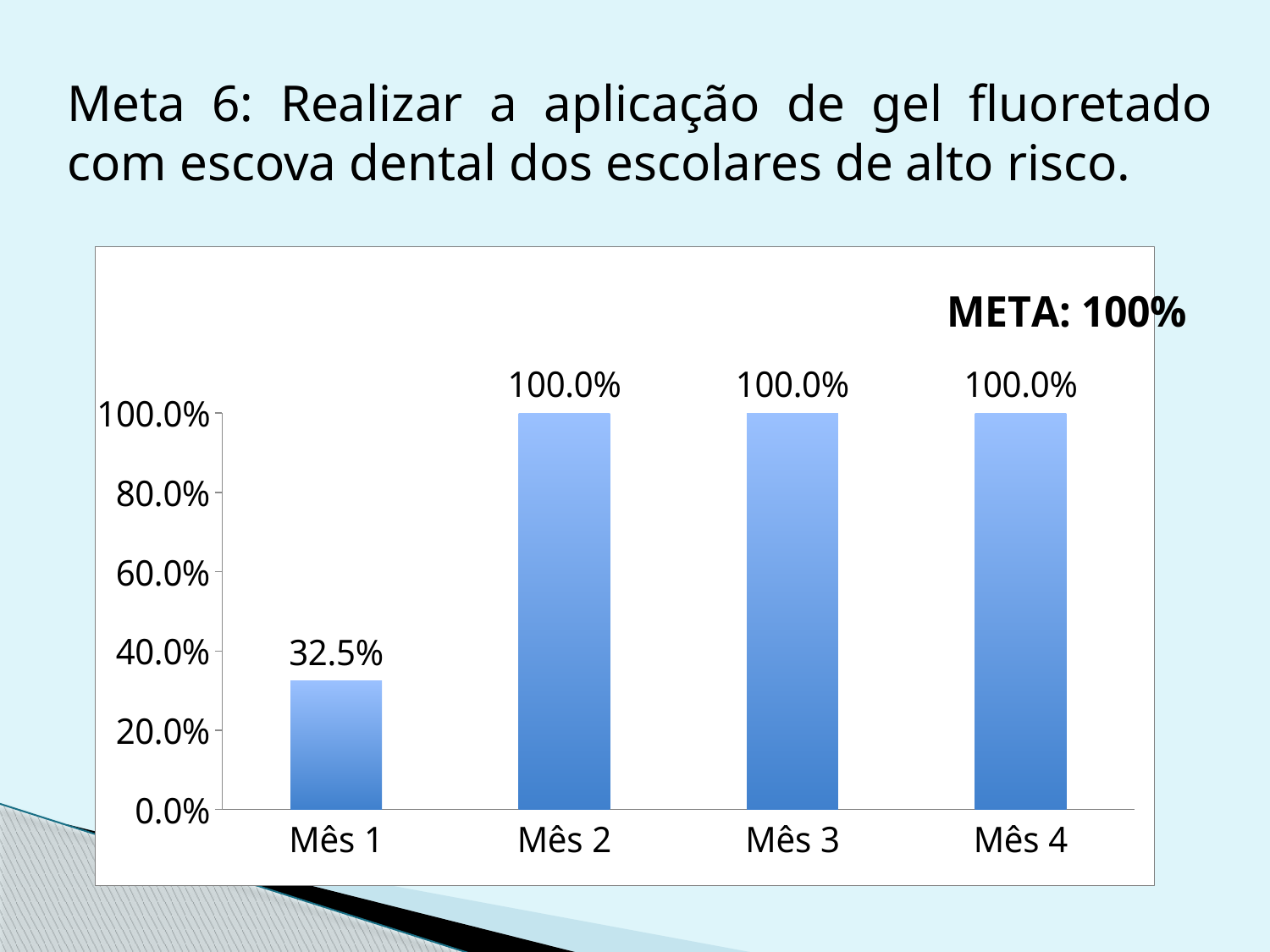
How many months are shown on the x axis? 4 How many months reached 100.0%? 3 Which month has the lowest value? Mês 1 Do the values rise or fall from Mês 1 to Mês 2? rise Is the value for Mês 1 greater or less than 40.0%? less Which is larger, the value for Mês 1 or the value for Mês 3? Mês 3 What is the value for Mês 1? 32.5% What target (META) is stated on the chart? 100% What kind of chart is shown on the slide? bar chart What is the difference between the values for Mês 2 and Mês 1? 67.5% What is the value for Mês 4? 100.0% What is the value for Mês 2? 100.0%